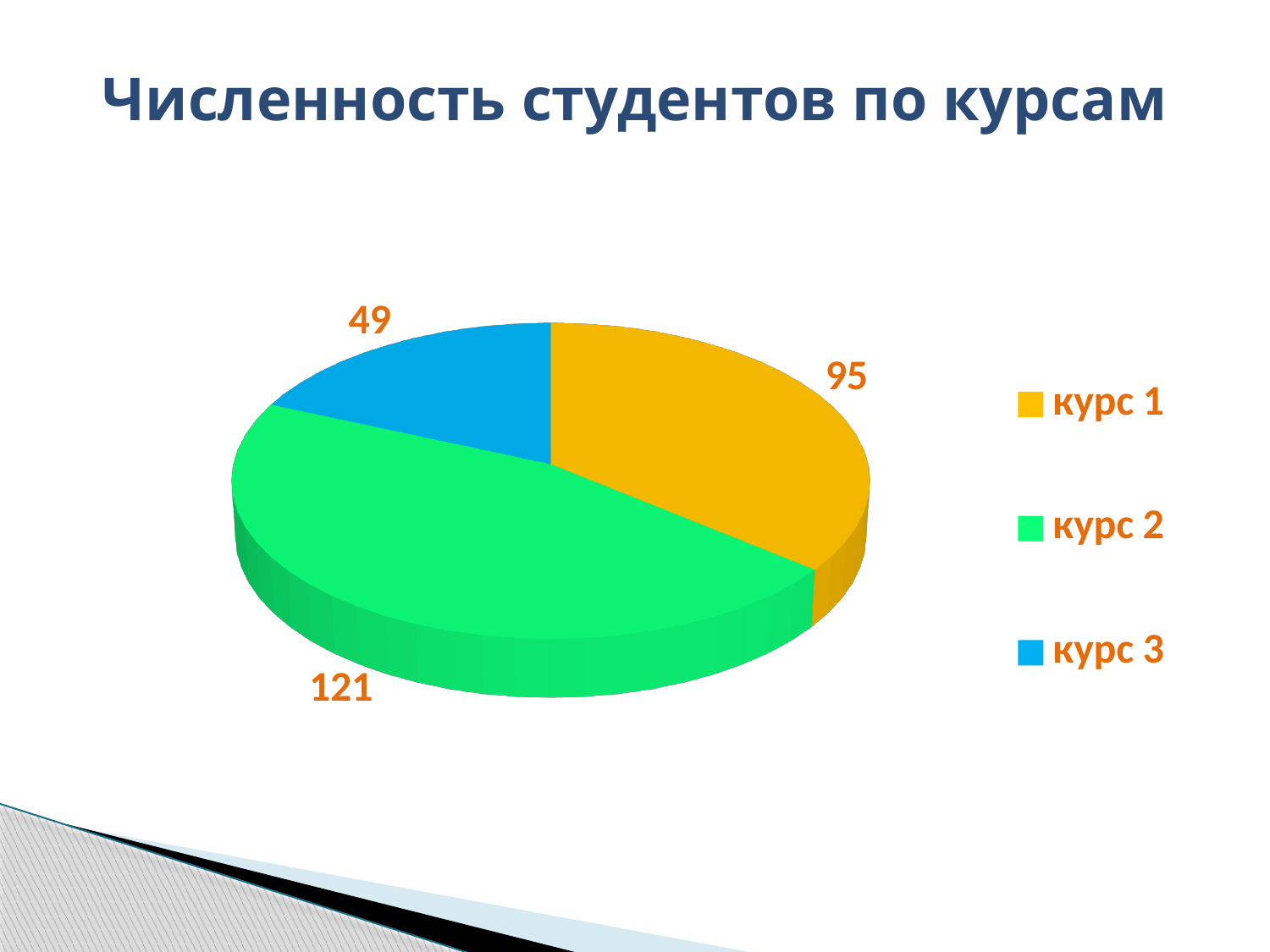
What is the value for курс 1? 95 Which course has the largest number of students? курс 2 How many slices does the pie chart have? 3 What is the value for курс 3? 49 What is the value for курс 2? 121 What is the difference between the values for курс 2 and курс 1? 26 What is the title of the chart? Численность студентов по курсам What kind of chart is shown on the slide? pie chart What is the total of all three slices? 265 Which is larger, the value for курс 1 or the value for курс 3? курс 1 What is the difference between the values for курс 1 and курс 3? 46 Which course has the smallest number of students? курс 3